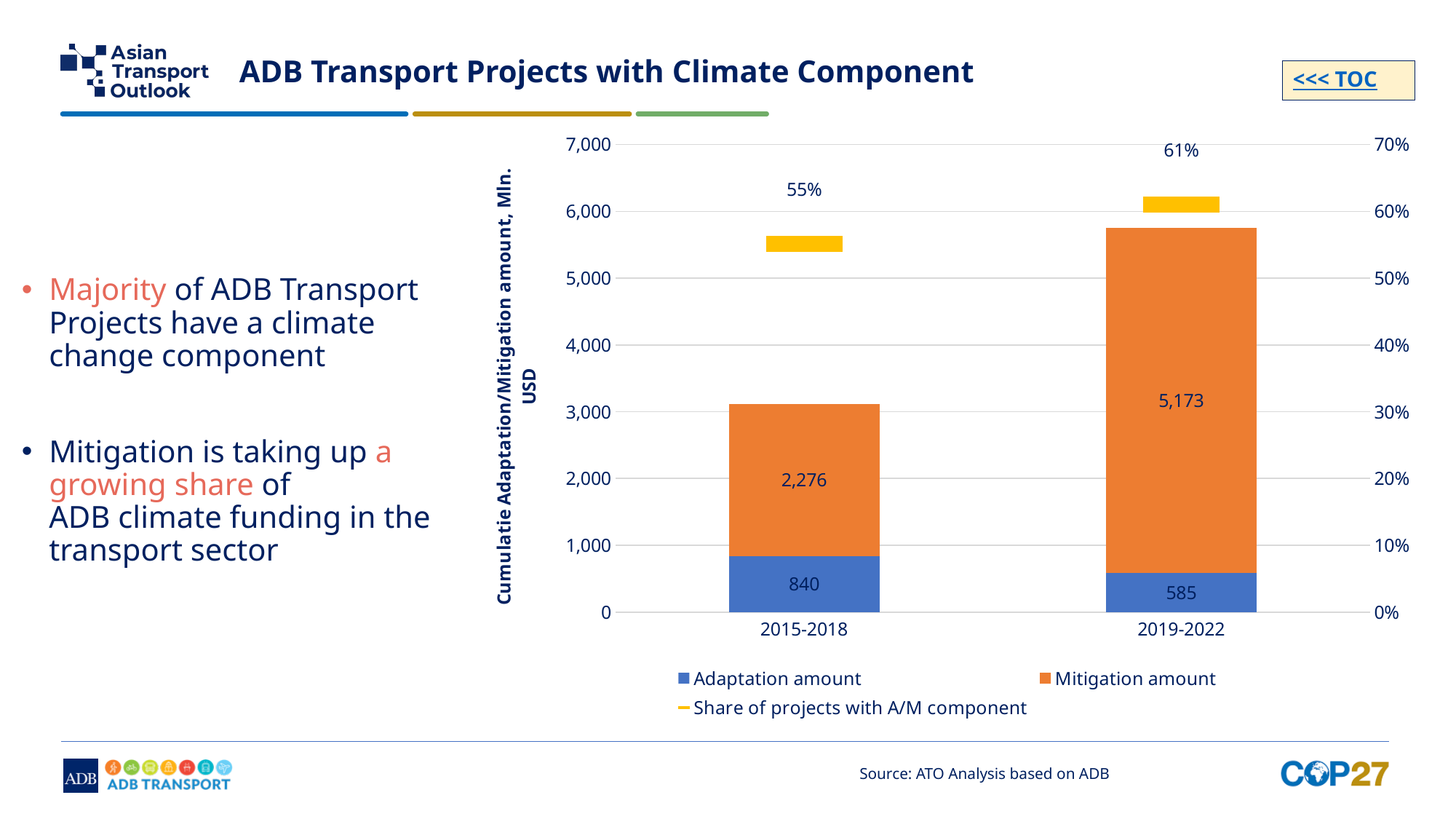
What is the total of the stacked bar for 2015-2018? 3,116 How many series does the legend list? 3 What is the Adaptation amount for 2015-2018? 840 What is the Share of projects with A/M component for 2015-2018? 55% What is the difference between the Mitigation amounts for 2019-2022 and 2015-2018? 2,897 What is the Share of projects with A/M component for 2019-2022? 61% Is the Adaptation amount for 2015-2018 greater or less than 1,000? less What is the total of the stacked bar for 2019-2022? 5,758 Which period has the higher Mitigation amount? 2019-2022 What is the Mitigation amount for 2019-2022? 5,173 What kind of chart is shown on the slide? Combination chart: stacked bar chart with a line series (share markers) on a secondary axis Which period has the lower Adaptation amount? 2019-2022